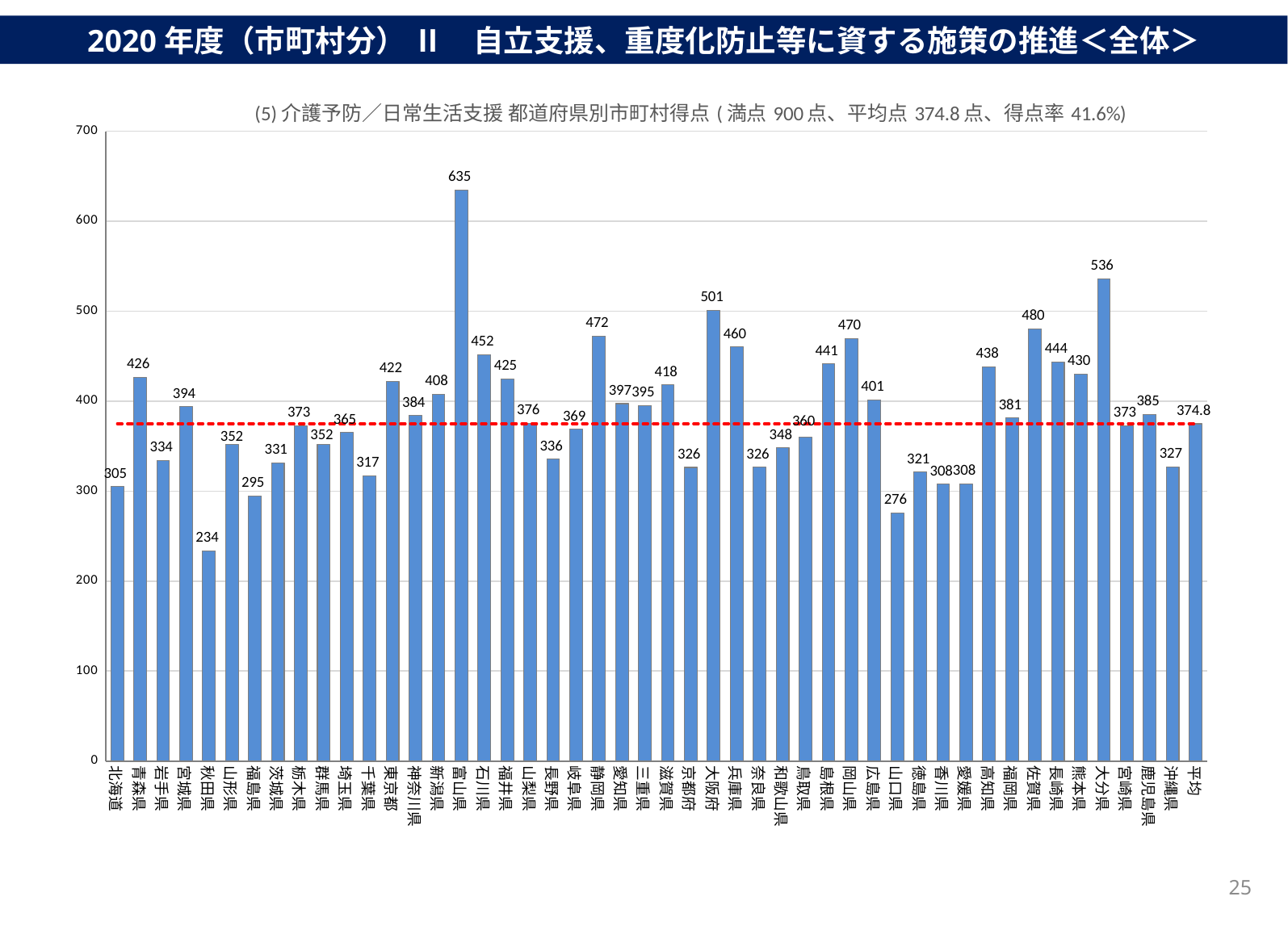
What is the value for 富山県? 635 What kind of chart is shown on the slide? bar chart How many bars are plotted in the chart? 48 What is the difference between the values for 青森県 and 北海道? 121 Is the value for 山口県 greater or less than 300? less What is the value for 大分県? 536 What is the value shown for 平均? 374.8 Which has a larger value, 大阪府 or 兵庫県? 大阪府 What is the value for 秋田県? 234 Which prefecture has the highest score? 富山県 Which prefecture has the lowest score? 秋田県 What is the difference between the values for 富山県 and 大分県? 99